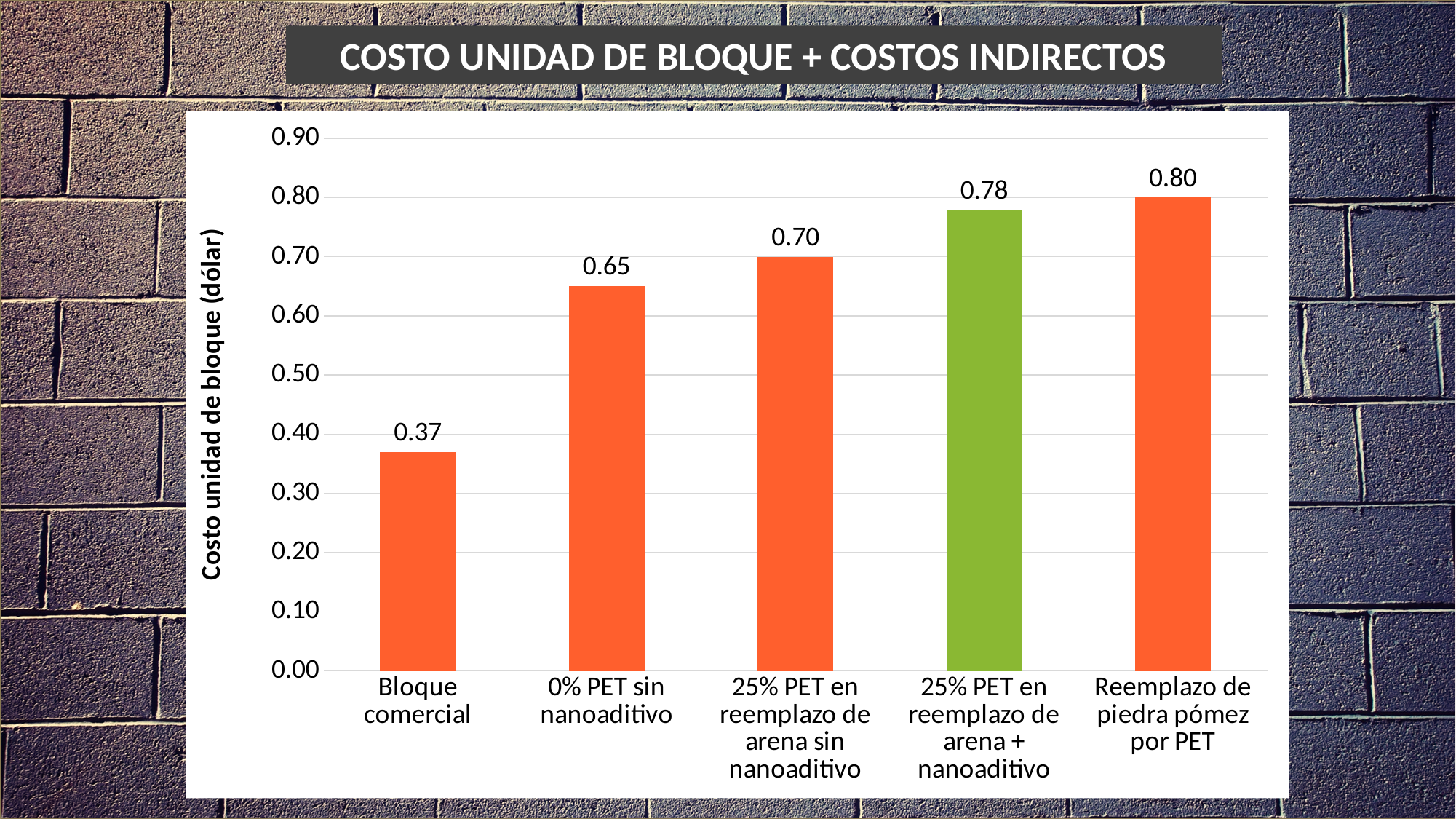
Which category has the lowest cost per block unit? Bloque comercial Which is larger: the value for '0% PET sin nanoaditivo' or the value for '25% PET en reemplazo de arena sin nanoaditivo'? 25% PET en reemplazo de arena sin nanoaditivo Do the values rise or fall from left to right along the x axis? Rise What is the difference between the values for '25% PET en reemplazo de arena sin nanoaditivo' and '0% PET sin nanoaditivo'? 0.05 What is the value shown for '25% PET en reemplazo de arena + nanoaditivo'? 0.78 Which category has the highest cost per block unit? Reemplazo de piedra pómez por PET Which category's bar is coloured green rather than orange? 25% PET en reemplazo de arena + nanoaditivo How many categories are shown on the x axis? 5 What is the cost per block unit for 'Bloque comercial'? 0.37 What is the difference between the values for 'Reemplazo de piedra pómez por PET' and 'Bloque comercial'? 0.43 What is the value shown for 'Reemplazo de piedra pómez por PET'? 0.80 What kind of chart is shown on the slide? Bar chart